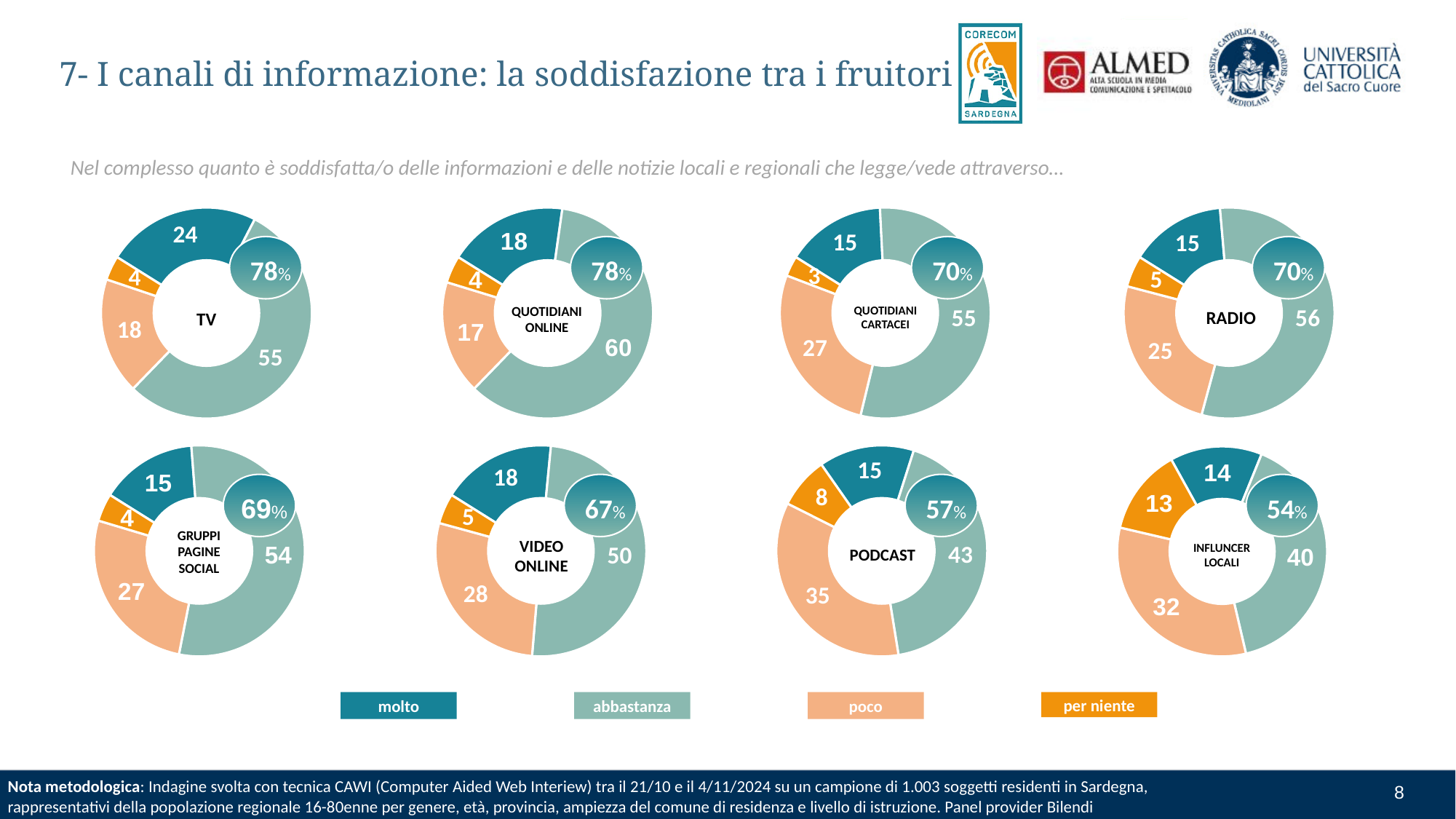
In the VIDEO ONLINE donut chart, what is the difference between the "abbastanza" value and the "poco" value? 22 Which is larger: the "molto" value in the TV chart or the "molto" value in the QUOTIDIANI ONLINE chart? TV How many donut charts are shown on the slide? 8 In the RADIO donut chart, what is the value for "molto"? 15 How many categories does the legend at the bottom of the slide list? 4 In the QUOTIDIANI CARTACEI donut chart, which category has the smallest value? per niente In the INFLUNCER LOCALI donut chart, what is the value for "per niente"? 13 What percentage is shown in the circle overlay on the PODCAST donut chart? 57% In the PODCAST donut chart, what is the value for "poco"? 35 In the TV donut chart, what is the value for "abbastanza"? 55 What type of chart is used for the TV data? donut chart In the TV donut chart, which category has the largest value? abbastanza